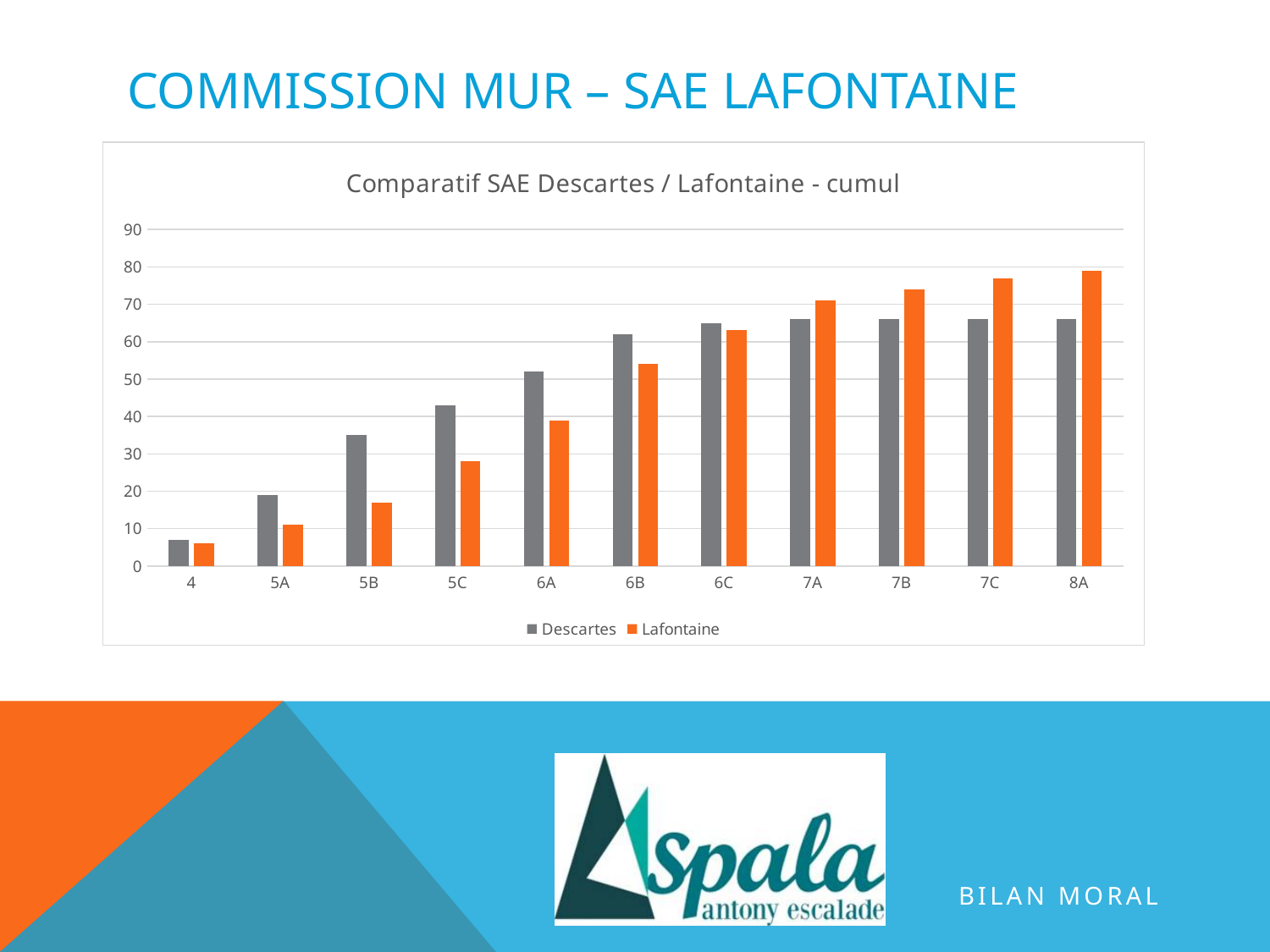
At 8A, which series has the larger value, Descartes or Lafontaine? Lafontaine Which category has the highest value for Lafontaine? 8A How many series does the legend list? 2 Is the value for Lafontaine at 8A greater or less than 70? greater Do the Lafontaine values rise or fall from 4 to 8A along the x axis? rise How many categories are shown on the x axis? 11 Is the value for Descartes at 5B greater or less than 30? greater What kind of chart is shown on the slide? bar chart Which category has the lowest value for Descartes? 4 What is the title of the chart? Comparatif SAE Descartes / Lafontaine - cumul Is the value for Lafontaine at 5A greater or less than 20? less At 5B, which series has the larger value, Descartes or Lafontaine? Descartes